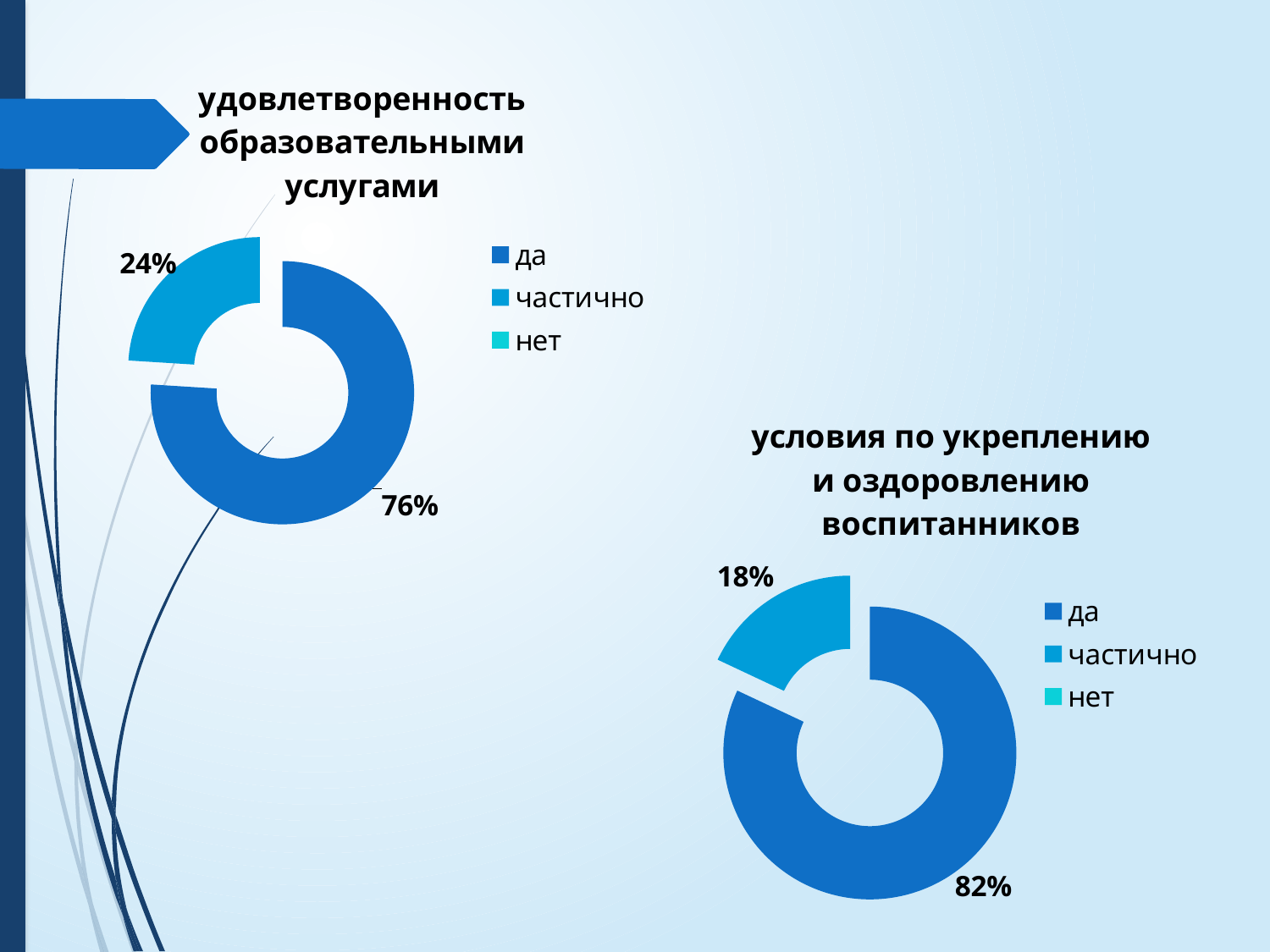
In the chart titled 'условия по укреплению и оздоровлению воспитанников', which labelled category has the smallest share? частично What kind of chart is the chart titled 'удовлетворенность образовательными услугами'? doughnut chart In the chart titled 'удовлетворенность образовательными услугами', what is the difference between the 'да' and 'частично' shares? 52% In the chart titled 'удовлетворенность образовательными услугами', which category has the largest share? да In the chart titled 'условия по укреплению и оздоровлению воспитанников', what percentage is shown for 'да'? 82% How many entries does the legend of the chart titled 'условия по укреплению и оздоровлению воспитанников' list? 3 In the chart titled 'условия по укреплению и оздоровлению воспитанников', what is the difference between the 'да' and 'частично' shares? 64% Which chart shows a larger share for 'да': the left chart or the right chart? the right chart What is the title of the chart in the lower right of the slide? условия по укреплению и оздоровлению воспитанников In the chart titled 'условия по укреплению и оздоровлению воспитанников', what percentage is shown for 'частично'? 18% In the chart titled 'удовлетворенность образовательными услугами', what percentage is shown for 'да'? 76% In the chart titled 'удовлетворенность образовательными услугами', what percentage is shown for 'частично'? 24%